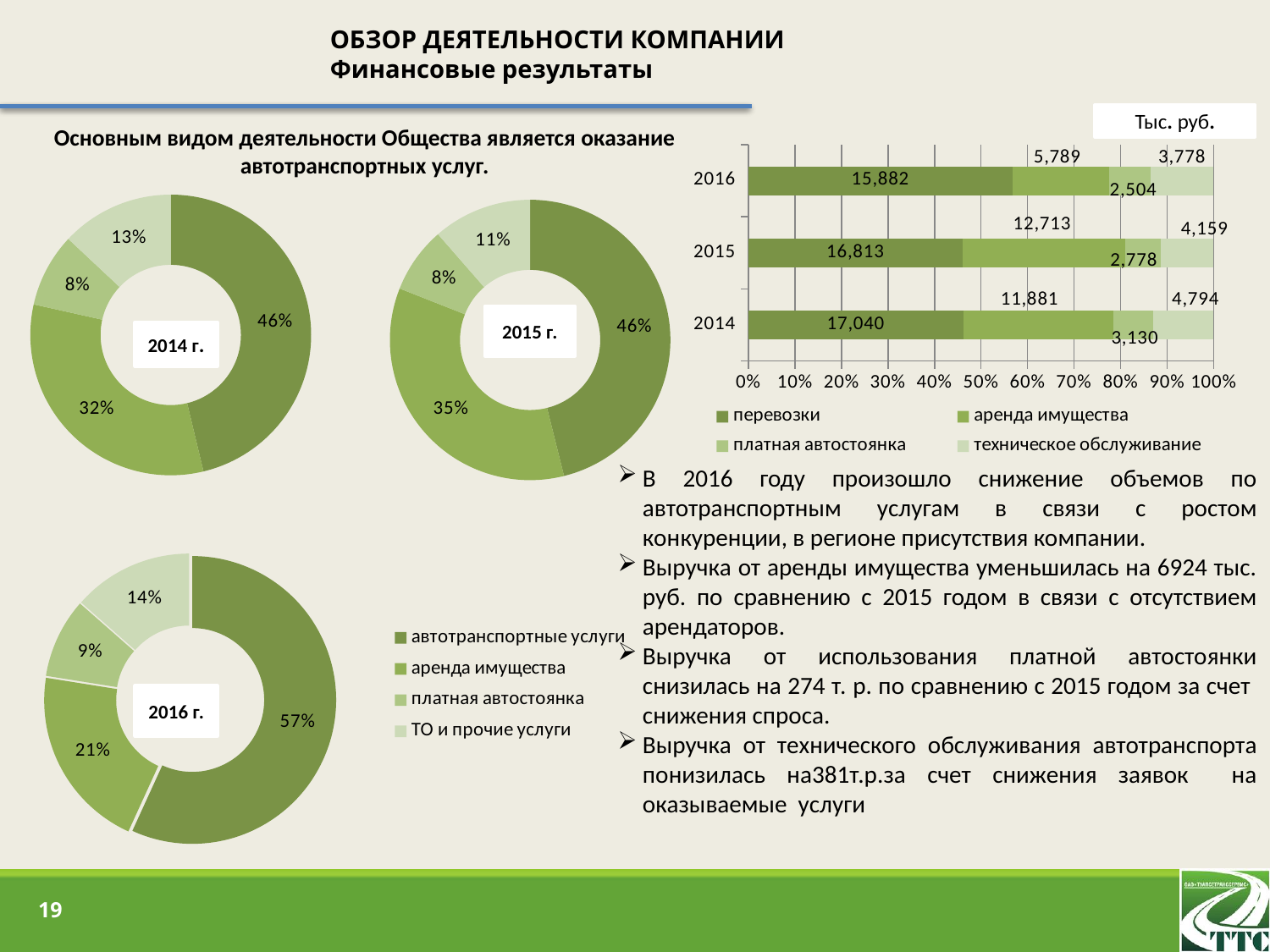
In the stacked bar chart at the top right, what is the value for техническое обслуживание in 2014? 4,794 In the stacked bar chart at the top right, is the value for платная автостоянка larger in 2015 or in 2016? 2015 In the stacked bar chart at the top right, what is the value for перевозки in 2016? 15,882 What kind of chart is the chart at the top right of the slide? Stacked bar chart In the 2014 г. donut chart, what is the smallest slice? 8% In the stacked bar chart at the top right, what is the value for аренда имущества in 2015? 12,713 In the 2015 г. donut chart, what share does аренда имущества have? 35% In the stacked bar chart at the top right, by how much did аренда имущества decrease from 2015 to 2016? 6,924 In the stacked bar chart at the top right, what is the total of the 2016 bar? 27,953 In the stacked bar chart at the top right, which year has the highest value for перевозки? 2014 How many series does the legend of the stacked bar chart at the top right list? 4 In the 2016 г. donut chart, what share do автотранспортные услуги have? 57%